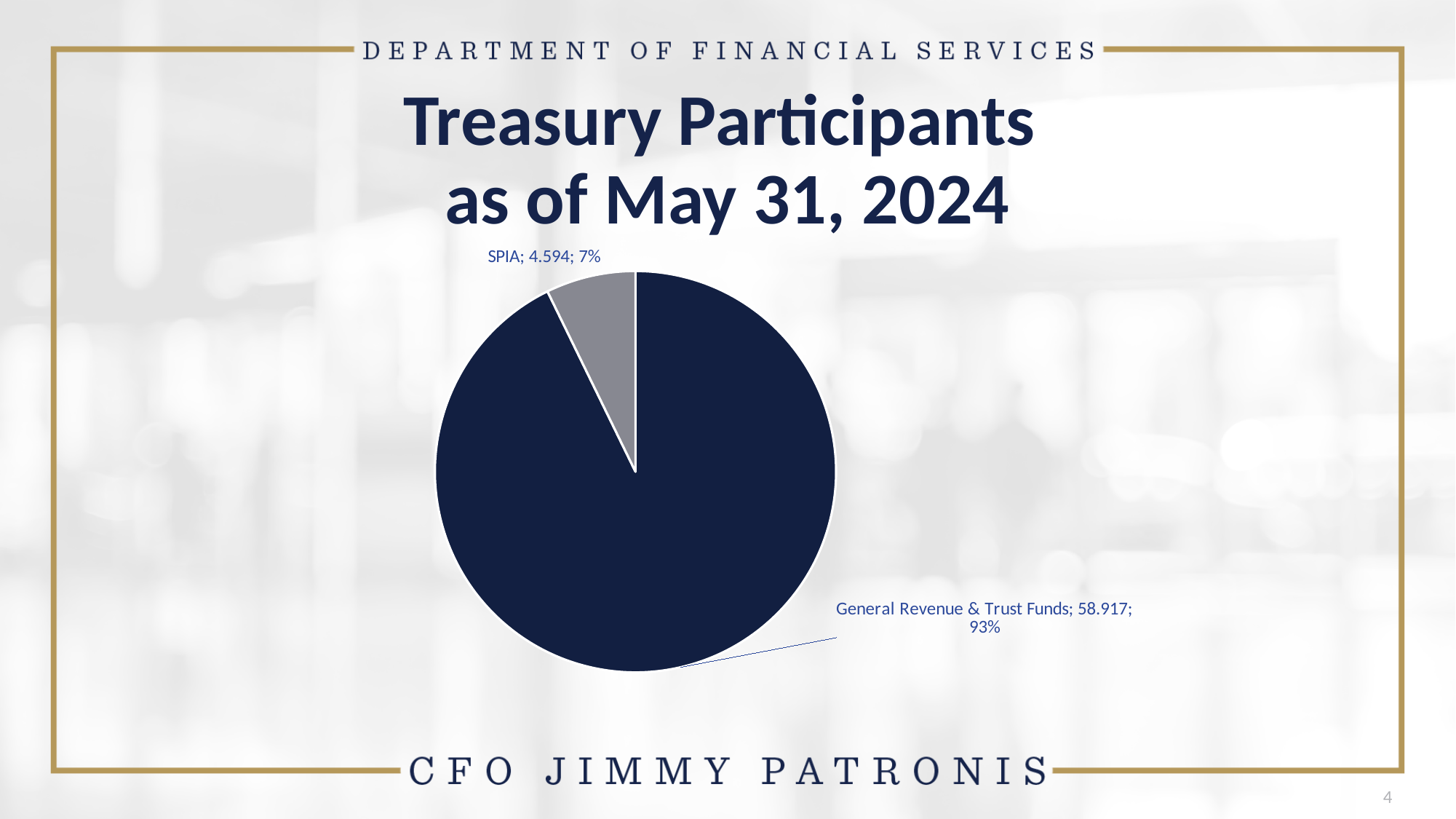
What is the title of the slide containing the chart? Treasury Participants as of May 31, 2024 What is the total of the two values shown in the pie chart? 63.511 Which is larger, the value for SPIA or the value for General Revenue & Trust Funds? General Revenue & Trust Funds How many categories are shown in the pie chart? 2 Which category has the largest slice? General Revenue & Trust Funds What is the value for SPIA? 4.594 What is the difference between the General Revenue & Trust Funds value and the SPIA value? 54.323 What kind of chart is shown on the slide? Pie chart What share of the pie does General Revenue & Trust Funds represent? 93% What is the value for General Revenue & Trust Funds? 58.917 Which category has the smallest slice? SPIA What share of the pie does SPIA represent? 7%